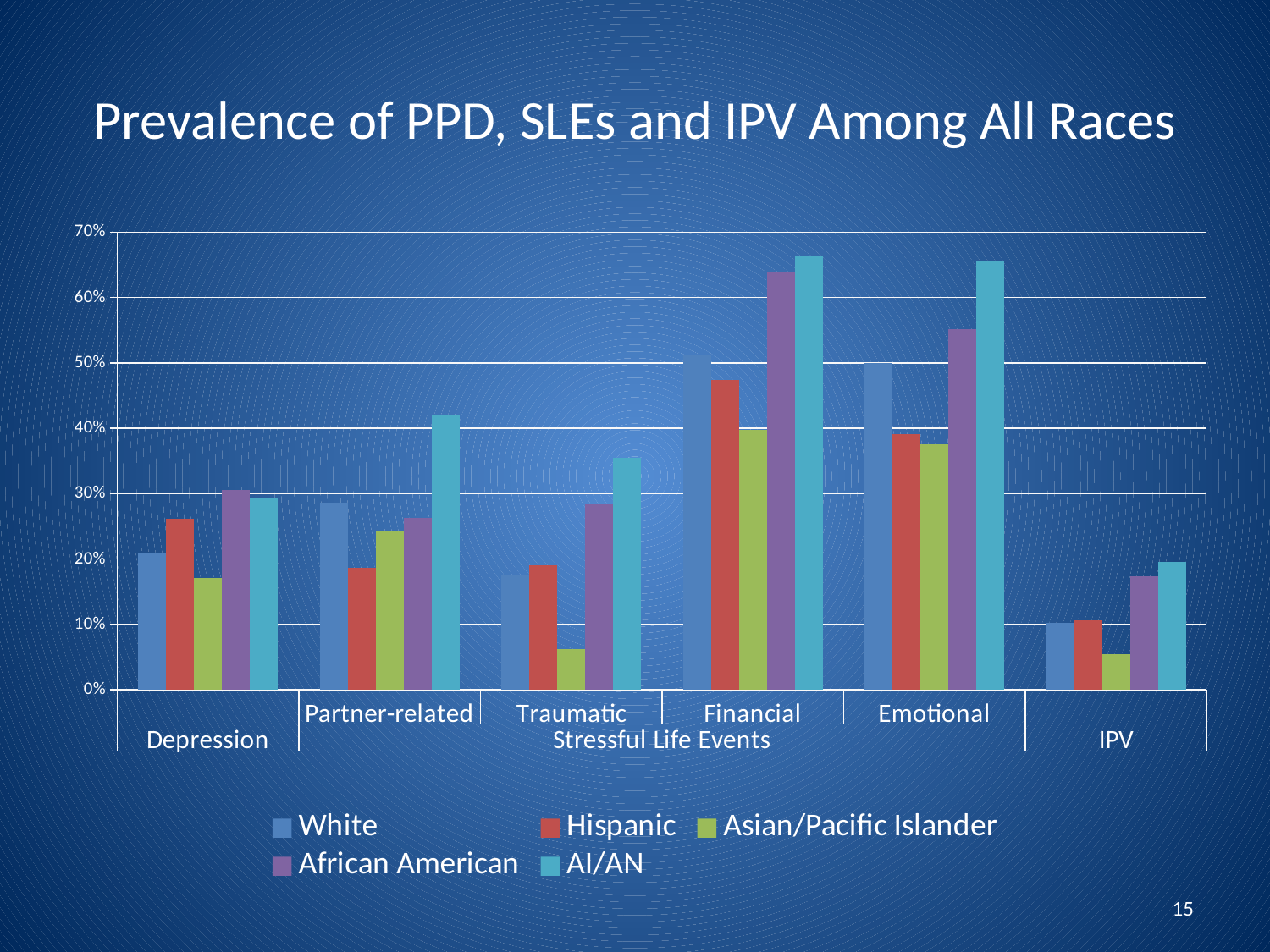
Is the value for Hispanic in the Depression category greater or less than 20%? greater Is the value for White in the Emotional category greater or less than 40%? greater In the Financial category, which is larger: the value for African American or the value for Hispanic? African American What kind of chart is shown on the slide? bar chart What is the title of the chart? Prevalence of PPD, SLEs and IPV Among All Races Is the value for AI/AN in the Financial category greater or less than 60%? greater How many categories are shown along the x axis? 6 Which race has the highest value in the Partner-related category? AI/AN Which category has the lowest value for African American? IPV Which race has the lowest value in the Traumatic category? Asian/Pacific Islander How many series does the legend list? 5